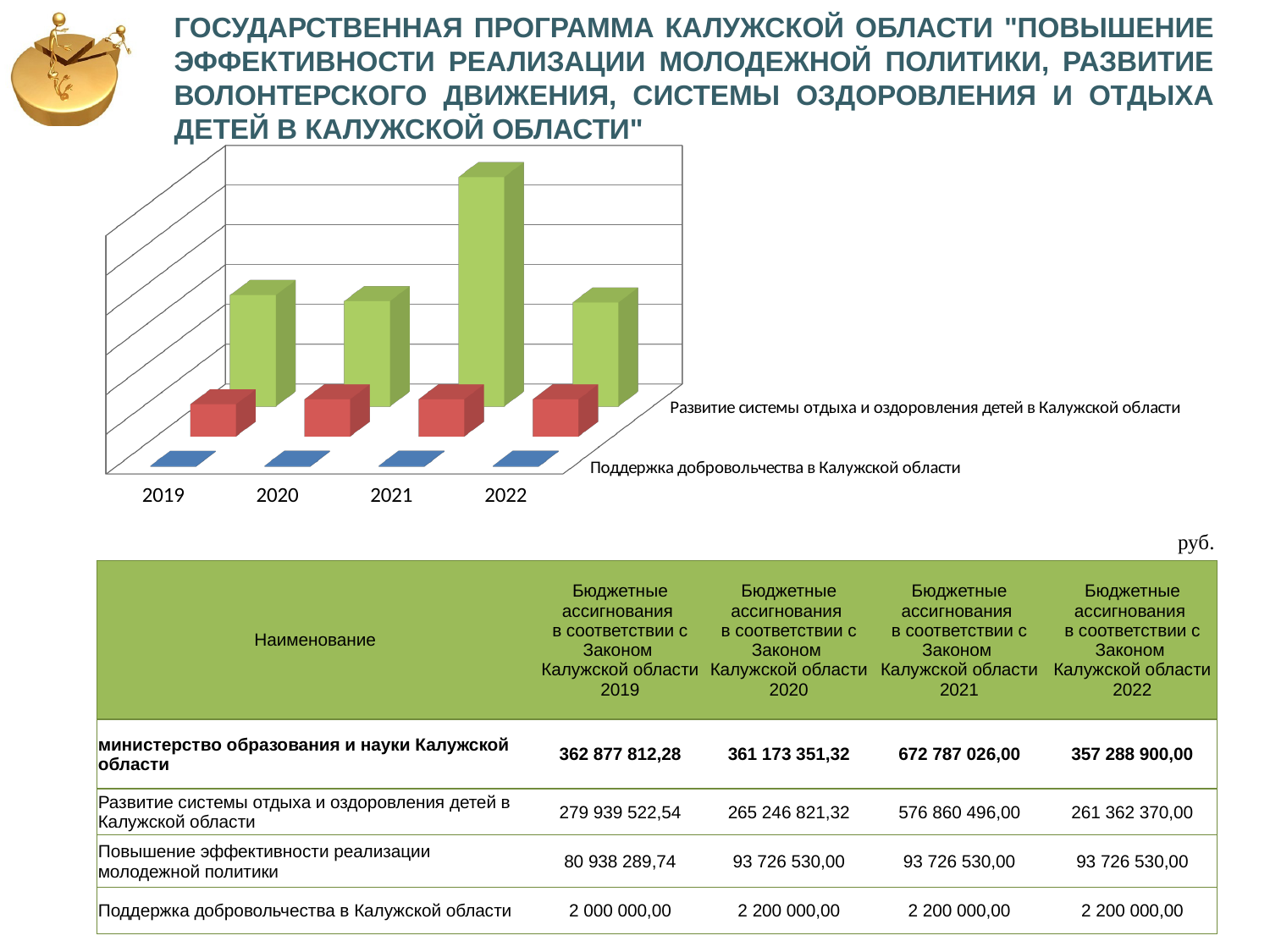
What kind of chart is shown on the slide? Bar chart Which series has the lowest bars in every year of the chart? Поддержка добровольчества в Калужской области Which years are shown on the x axis of the chart? 2019, 2020, 2021, 2022 According to the table, what is the value for 'Поддержка добровольчества в Калужской области' in 2019? 2 000 000,00 How many years are shown along the x axis of the chart? 4 According to the table, what is the value for 'Развитие системы отдыха и оздоровления детей в Калужской области' in 2021? 576 860 496,00 Does the bar for 'Развитие системы отдыха и оздоровления детей в Калужской области' rise or fall from 2021 to 2022? Fall For 'Развитие системы отдыха и оздоровления детей в Калужской области', is the bar for 2021 or 2022 taller? 2021 In which year is the bar for 'Развитие системы отдыха и оздоровления детей в Калужской области' the tallest? 2021 In 2022, are the red bars or the blue bars taller in the chart? Red By how much does the value for 'Поддержка добровольчества в Калужской области' in 2020 exceed the value in 2019? 200 000,00 Which series is drawn with the green bars in the chart? Развитие системы отдыха и оздоровления детей в Калужской области